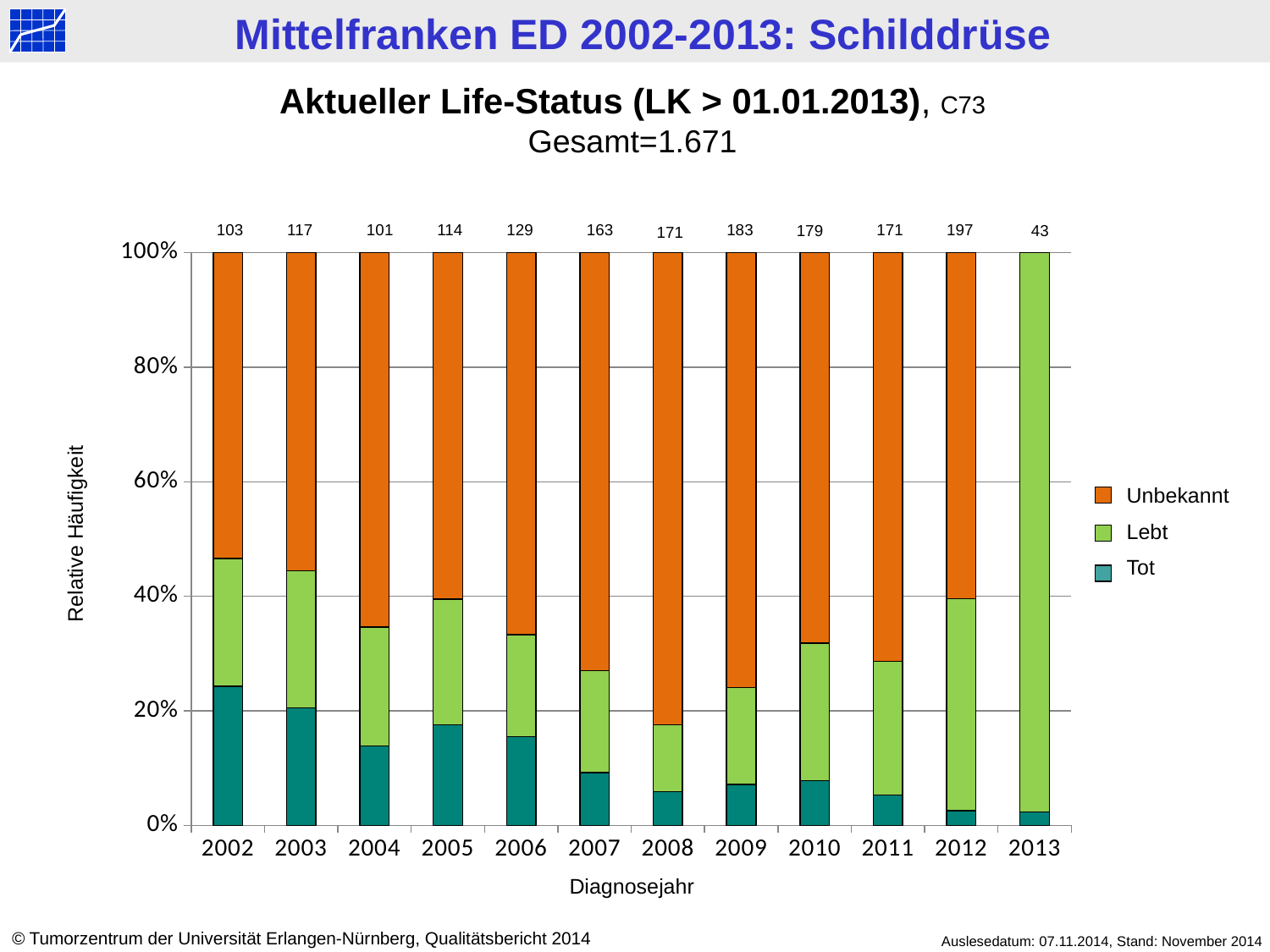
Which year has the lowest number printed above its bar? 2013 How many years are shown on the x axis? 12 Is the share of Lebt in 2013 greater or less than 80%? greater Which year has the larger number printed above its bar, 2009 or 2010? 2009 How many series does the legend list? 3 What is the number printed above the bar for 2002? 103 Which year has the highest number printed above its bar? 2012 What is the number printed above the bar for 2007? 163 What is the difference between the numbers printed above the bars for 2012 and 2013? 154 Is the share of Tot in 2002 greater or less than 20%? greater What kind of chart is shown on the slide? Stacked bar chart What is the number printed above the bar for 2012? 197